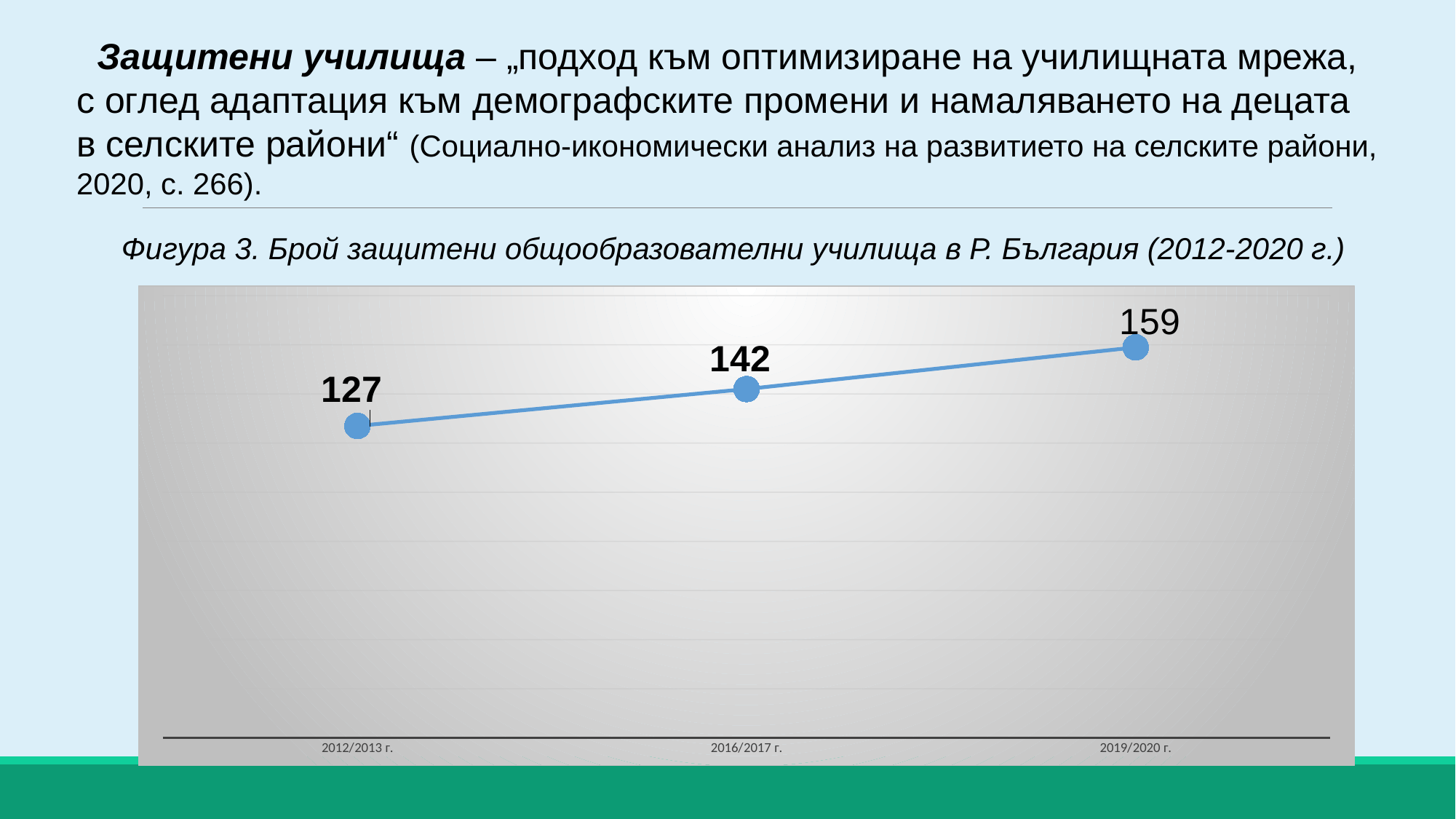
What is the number of protected schools for 2012/2013 г.? 127 Which is larger, the value for 2016/2017 г. or the value for 2019/2020 г.? 2019/2020 г. What is the number of protected schools for 2016/2017 г.? 142 Which school year has the lowest number of protected schools? 2012/2013 г. What is the difference between the values for 2016/2017 г. and 2012/2013 г.? 15 How many data points are plotted on the chart? 3 What kind of chart is shown on the slide? line chart Which school year has the highest number of protected schools? 2019/2020 г. What is the difference between the values for 2019/2020 г. and 2012/2013 г.? 32 Do the values rise or fall from 2012/2013 г. to 2019/2020 г.? rise What is the title of the figure shown on the slide? Фигура 3. Брой защитени общообразователни училища в Р. България (2012-2020 г.) What is the number of protected schools for 2019/2020 г.? 159